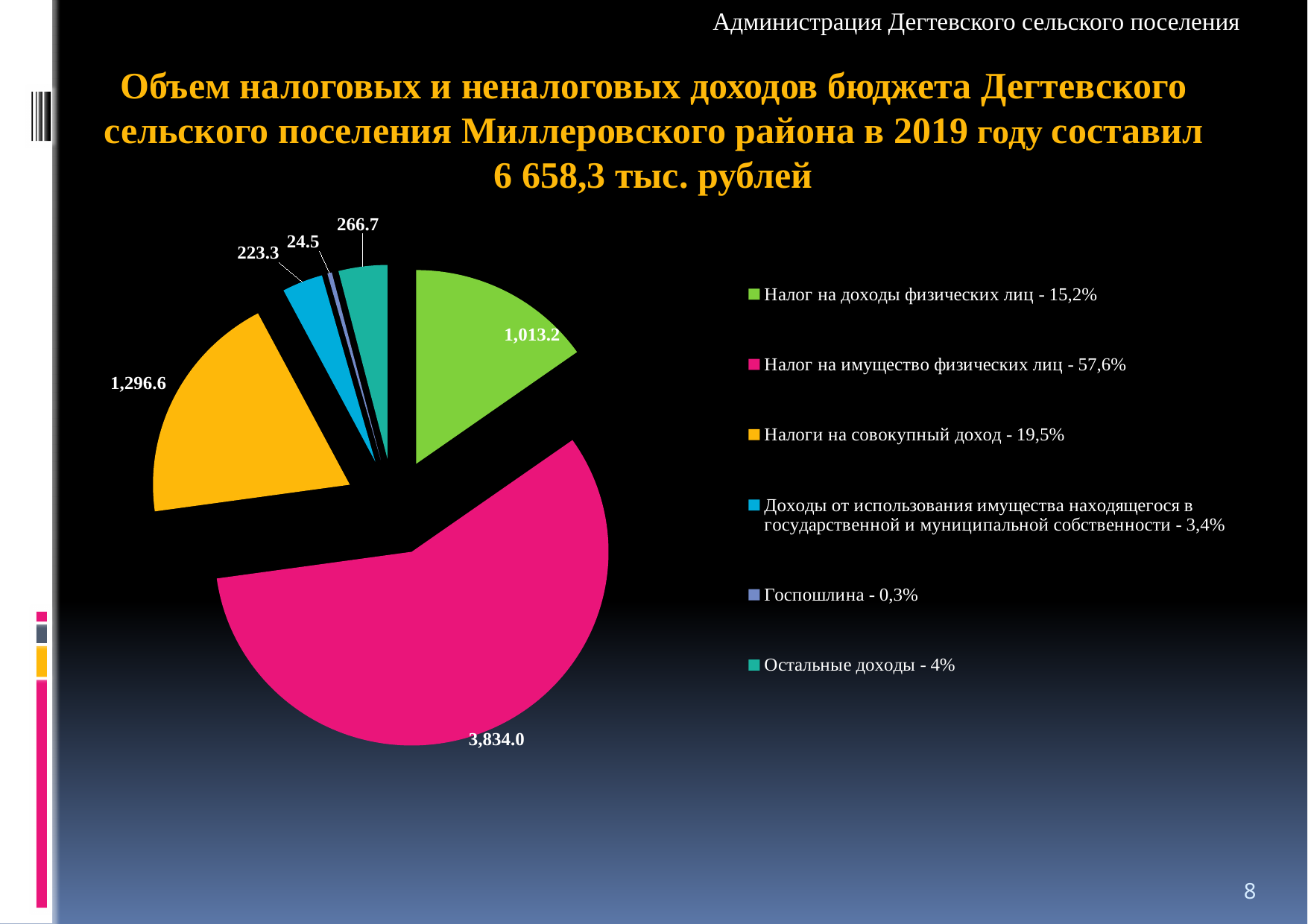
What is the value shown for Госпошлина? 24.5 What is the value shown for Налог на имущество физических лиц? 3,834.0 What share of the pie does Налог на доходы физических лиц represent, according to the legend? 15,2% Which category has the smallest slice of the pie? Госпошлина What colour is the slice for Налоги на совокупный доход? yellow What is the difference between the values for Налоги на совокупный доход and Налог на доходы физических лиц? 283.4 Which category has the largest slice of the pie? Налог на имущество физических лиц How many slices does the pie chart have? 6 What is the value shown for Остальные доходы? 266.7 What is the value shown for Налоги на совокупный доход? 1,296.6 Which is larger: the value for Остальные доходы or the value for Доходы от использования имущества находящегося в государственной и муниципальной собственности? Остальные доходы What kind of chart is shown on the slide? pie chart